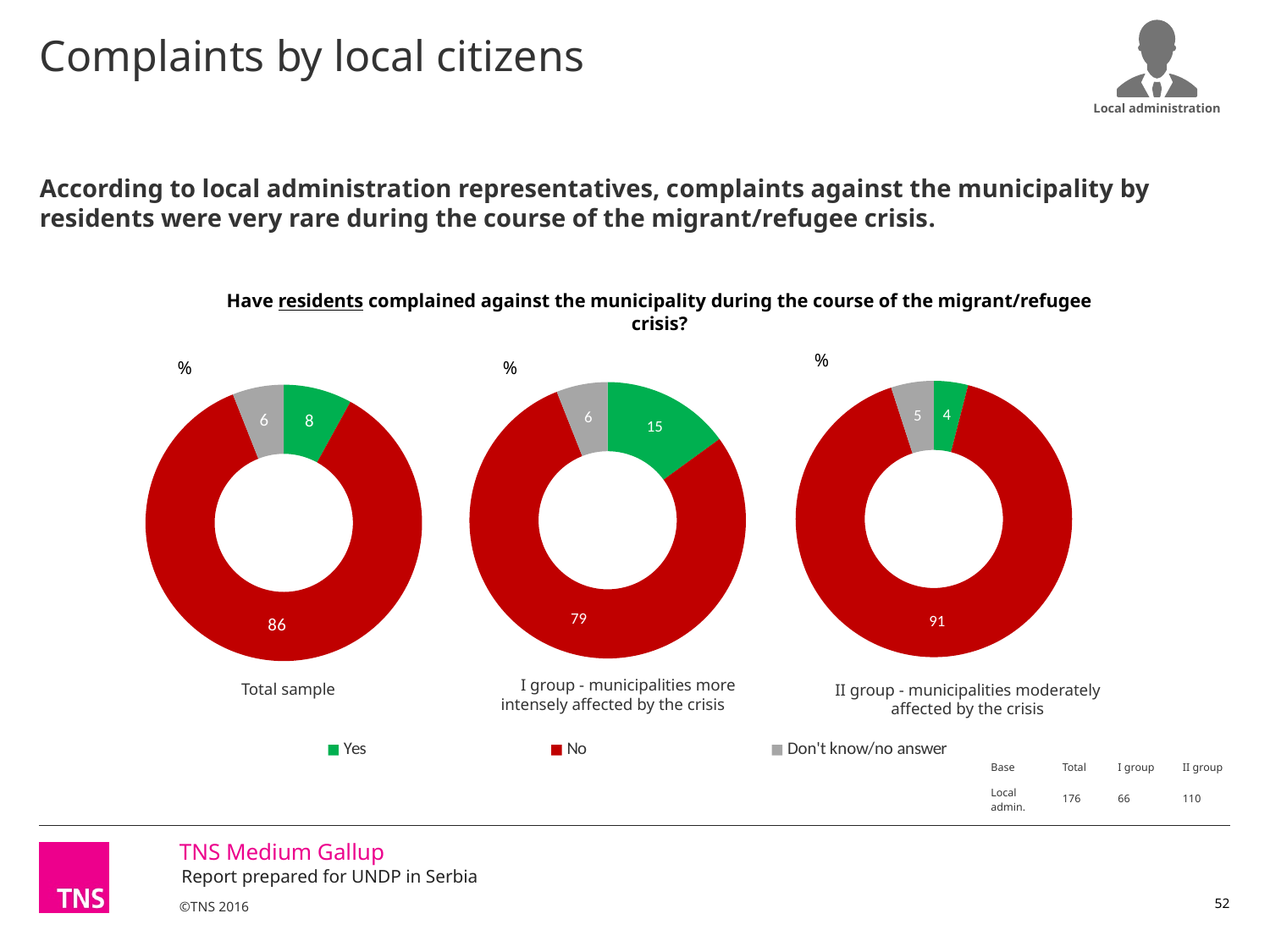
In the Total sample chart, what percentage answered No? 86 Is the Yes share larger in the Total sample chart or in the I group chart? I group chart In the II group chart (municipalities moderately affected by the crisis), what percentage answered No? 91 Which colour represents the No answer in the charts? Red Which of the three charts has the smallest Yes share? II group - municipalities moderately affected by the crisis What type of chart is used on this slide? Doughnut (pie) chart In the II group chart, what percentage answered Yes? 4 In the I group chart (municipalities more intensely affected by the crisis), what percentage answered Yes? 15 In the Total sample chart, what percentage answered Don't know/no answer? 6 How many categories does the legend list? 3 Which of the three charts has the largest Yes share? I group - municipalities more intensely affected by the crisis What is the difference between the No share in the II group chart and the No share in the I group chart? 12